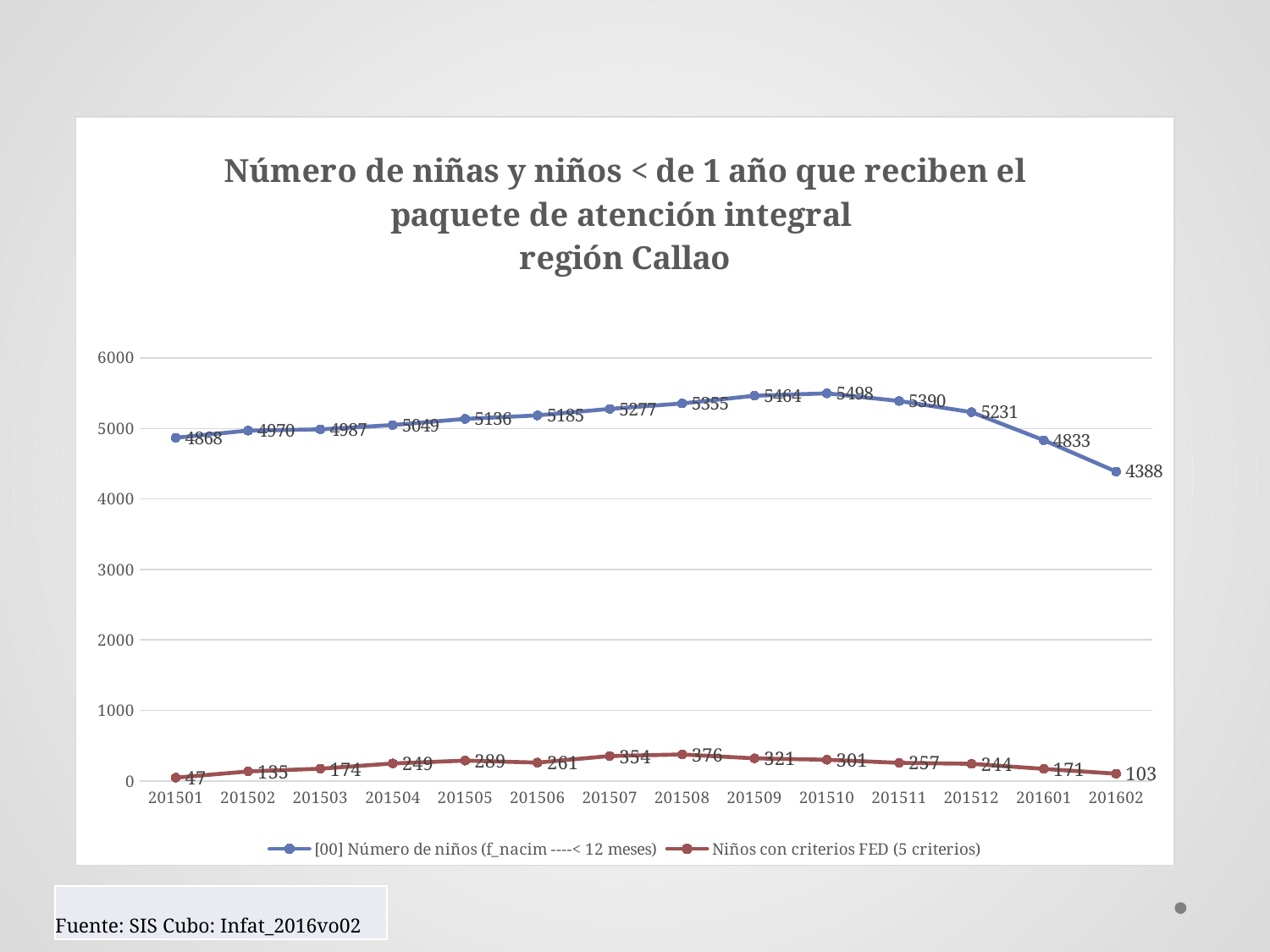
What is the difference between the '[00] Número de niños (f_nacim ----< 12 meses)' values for 201510 and 201602? 1110 What type of chart is shown on the slide? line chart Which is larger for 'Niños con criterios FED (5 criterios)': the value for 201505 or the value for 201506? 201505 How many series does the legend list? 2 What is the value of '[00] Número de niños (f_nacim ----< 12 meses)' for 201602? 4388 In which period is '[00] Número de niños (f_nacim ----< 12 meses)' at its highest? 201510 What is the value of 'Niños con criterios FED (5 criterios)' for 201508? 376 In which period is 'Niños con criterios FED (5 criterios)' at its lowest? 201501 What is the source cited below the chart? SIS Cubo: Infat_2016vo02 How many time periods are plotted along the x axis? 14 Does '[00] Número de niños (f_nacim ----< 12 meses)' rise or fall from 201510 to 201602? fall What is the value of '[00] Número de niños (f_nacim ----< 12 meses)' for 201510? 5498